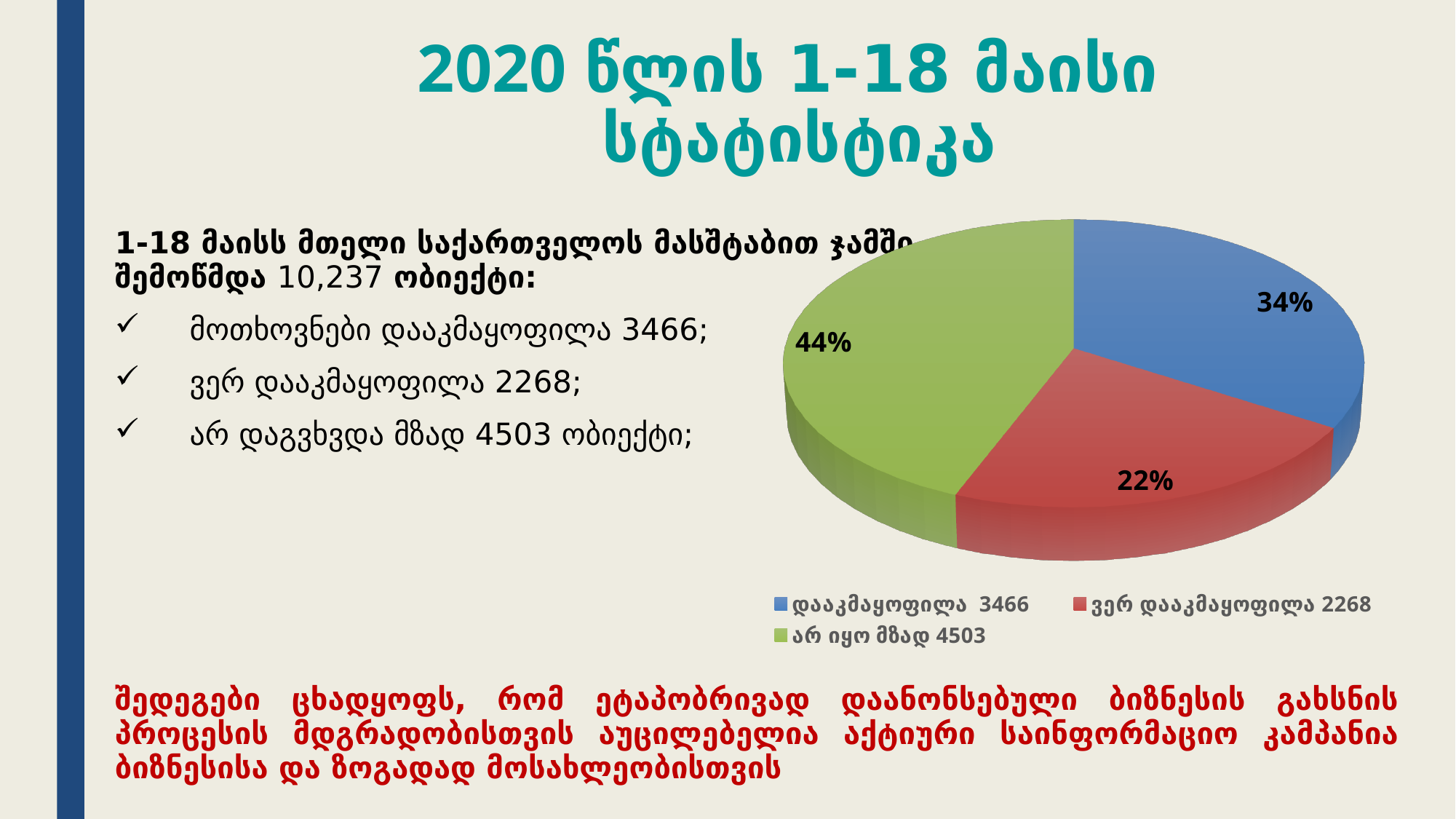
What is the difference in percentage points between the green slice (44%) and the red slice (22%)? 22 What percentage is shown for the red slice (ვერ დააკმაყოფილა 2268)? 22% What colour is the slice labelled 22%? red What percentage is shown for the blue slice (დააკმაყოფილა 3466)? 34% How many entries does the legend list? 3 How many slices does the pie chart have? 3 What number appears in the legend entry for the green slice? 4503 What percentage is shown for the green slice (არ იყო მზად 4503)? 44% What kind of chart is shown on the slide? pie chart Which slice of the pie chart is the smallest? ვერ დააკმაყოფილა 2268 Which is larger, the share for დააკმაყოფილა or the share for ვერ დააკმაყოფილა? დააკმაყოფილა Which slice of the pie chart is the largest? არ იყო მზად 4503